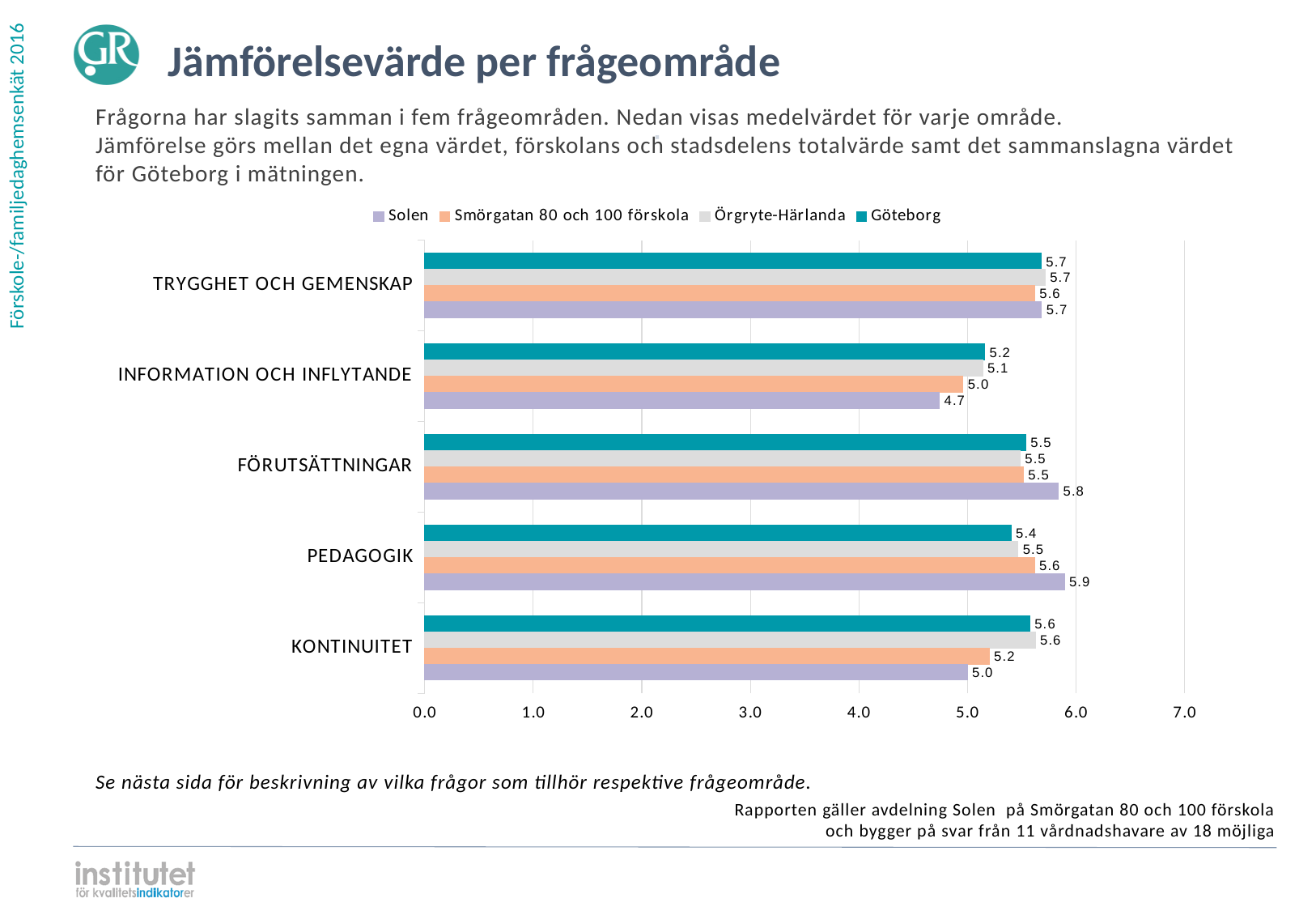
How many question areas (categories) are shown on the chart? 5 What is the value for Göteborg in the INFORMATION OCH INFLYTANDE category? 5.2 In the FÖRUTSÄTTNINGAR category, which is larger: the value for Solen or the value for Göteborg? Solen In which category does Solen have its highest value? PEDAGOGIK What is the value for Smörgatan 80 och 100 förskola in the KONTINUITET category? 5.2 In which category does Solen have its lowest value? INFORMATION OCH INFLYTANDE What is the value for Örgryte-Härlanda in the FÖRUTSÄTTNINGAR category? 5.5 What is the value for Solen in the PEDAGOGIK category? 5.9 Which series is shown in teal in the legend? Göteborg What kind of chart is shown on the slide? Bar chart What is the difference between the Solen value and the Göteborg value in the KONTINUITET category? 0.6 How many series does the legend list? 4